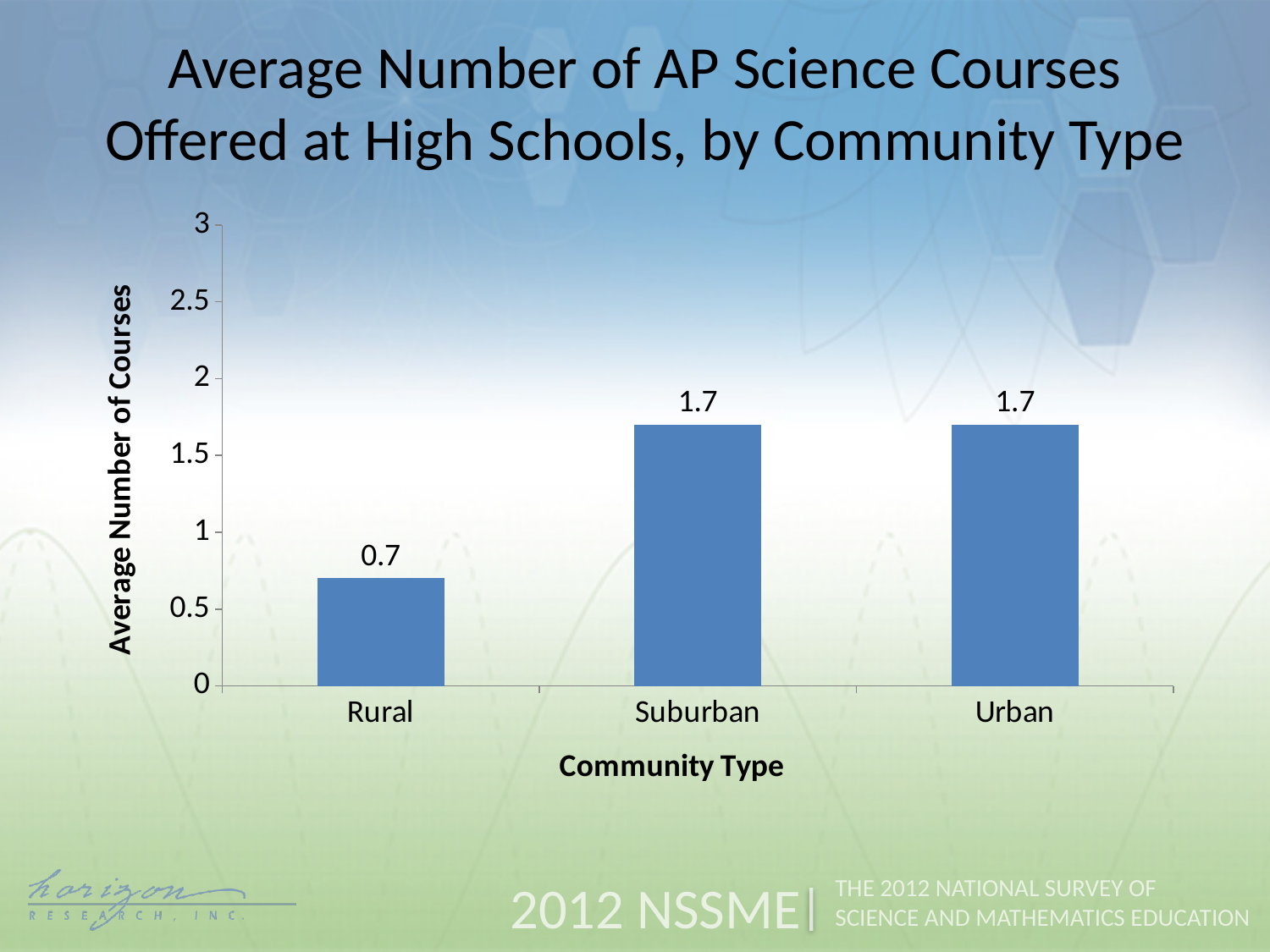
What is the label of the vertical axis? Average Number of Courses What is the average number of AP science courses offered at rural high schools? 0.7 Which community type has the lowest average number of AP science courses? Rural What is the difference between the average number of AP science courses at suburban and rural high schools? 1.0 What is the average number of AP science courses offered at urban high schools? 1.7 What is the average number of AP science courses offered at suburban high schools? 1.7 Is the value for Rural greater or less than 1? less Which is larger, the value for Rural or the value for Urban? Urban Is the value for Suburban greater or less than 1.5? greater What is the label of the horizontal axis? Community Type What kind of chart is shown on the slide? Bar chart How many community types are shown on the chart? 3